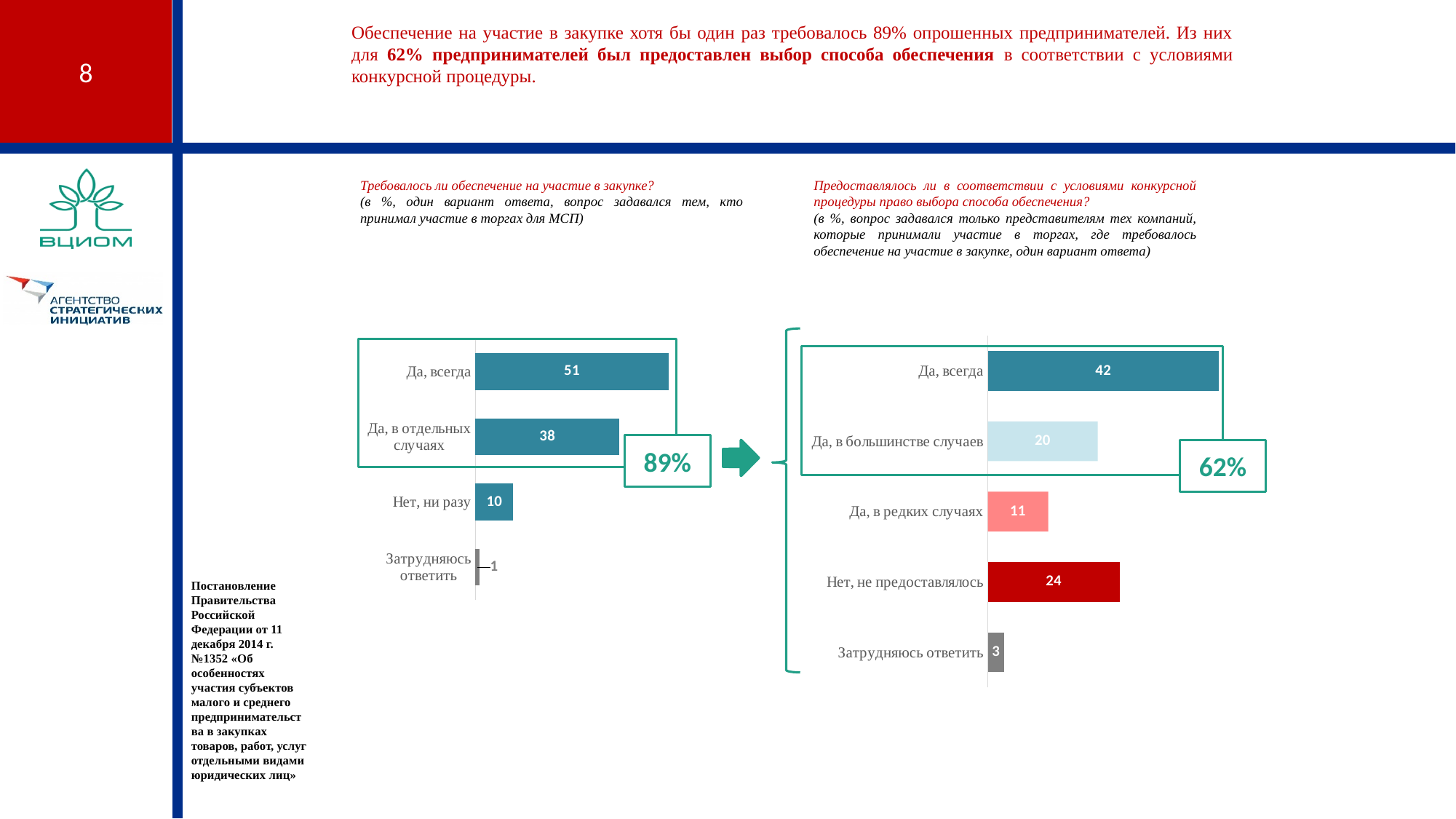
What type of chart is the left chart? Bar chart How many categories does the right chart show? 5 In the right chart, what is the difference between "Да, всегда" and "Да, в большинстве случаев"? 22 In the left chart, what is the value for "Нет, ни разу"? 10 In the right chart, which is larger: "Да, в большинстве случаев" or "Нет, не предоставлялось"? Нет, не предоставлялось In the left chart, what is the difference between "Да, всегда" and "Да, в отдельных случаях"? 13 In the left chart, what is the value for "Да, всегда"? 51 In the right chart, what is the value for "Нет, не предоставлялось"? 24 How many categories does the left chart show? 4 In the right chart, what is the value for "Да, в редких случаях"? 11 In the left chart, which category has the lowest value? Затрудняюсь ответить In the right chart, which category has the highest value? Да, всегда